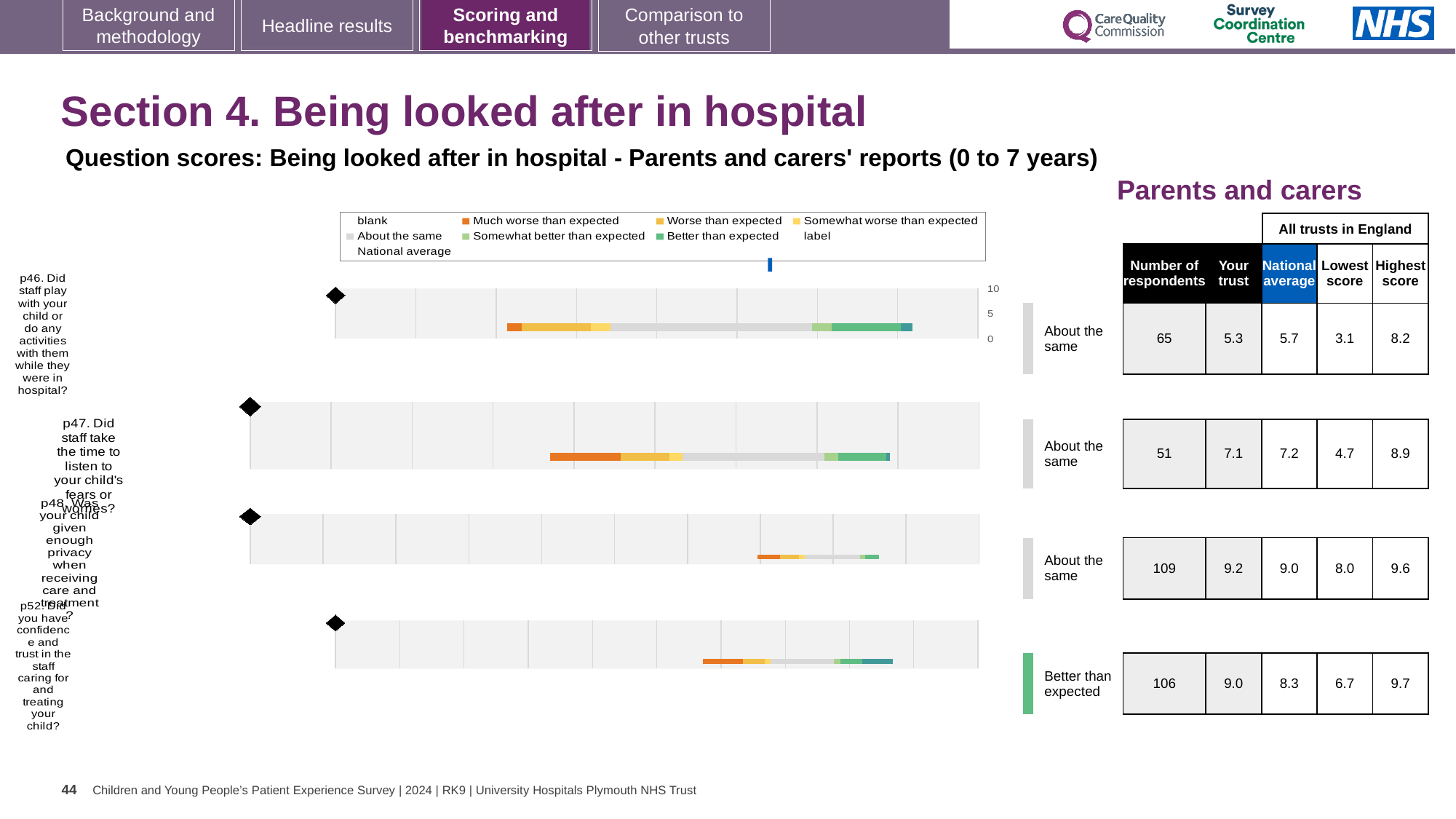
How many respondents answered p48 (Was your child given enough privacy when receiving care and treatment?)? 109 What is the difference between the national average and the 'Your trust' score for p46? 0.4 How many questions (bars) are plotted in the chart? 4 Which question's bar is labelled 'Better than expected' in the chart? p52. Did you have confidence and trust in the staff caring for and treating your child? For p52, is the 'Your trust' score or the national average higher? Your trust Which question has the highest 'Your trust' score? p48. Was your child given enough privacy when receiving care and treatment? What kind of chart is used to show the question scores on this slide? bar chart What is the lowest score among all trusts in England for p47? 4.7 Which question has the lowest 'Your trust' score? p46. Did staff play with your child or do any activities with them while they were in hospital? What is the 'Your trust' score for p46 (Did staff play with your child or do any activities with them while they were in hospital?)? 5.3 What is the national average score for p47 (Did staff take the time to listen to your child's fears or worries?)? 7.2 What is the highest score among all trusts in England for p52? 9.7